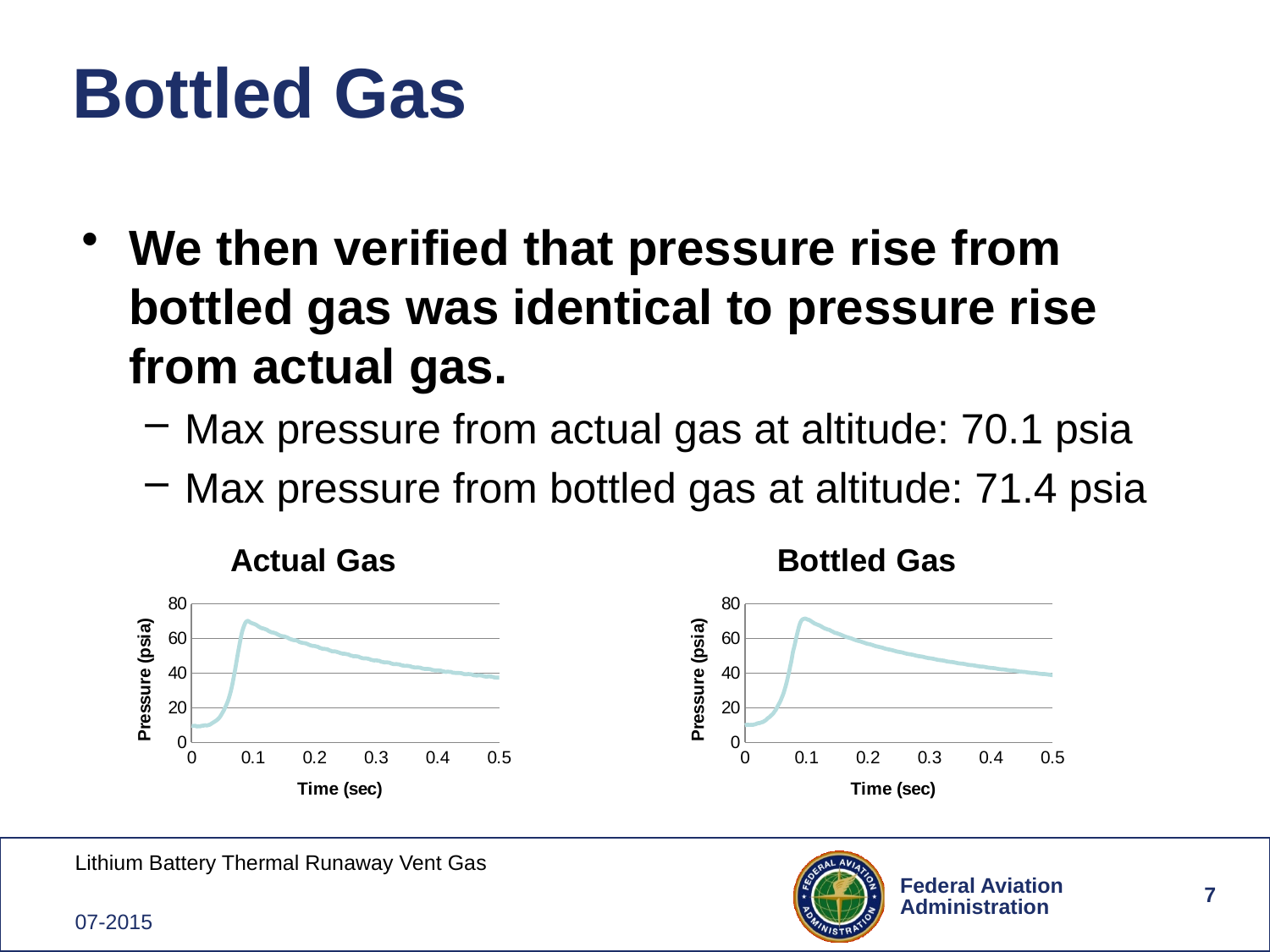
In the Actual Gas chart, is the pressure at 0.2 sec greater or less than 60? less What is the title of the y axis on the Bottled Gas chart? Pressure (psia) How many tick labels are shown on the x axis of the Bottled Gas chart? 6 In the Bottled Gas chart, is the pressure at time 0 greater or less than 20? less What kind of chart is the Bottled Gas chart? line chart In the Actual Gas chart, is the pressure at 0.5 sec greater or less than 40? less In the Actual Gas chart, after the peak near 0.1 sec, do the values rise or fall as time increases? fall What kind of chart is the Actual Gas chart? line chart In the Bottled Gas chart, between 0 and 0.1 sec, do the values rise or fall? rise What is the title of the x axis on the Actual Gas chart? Time (sec)